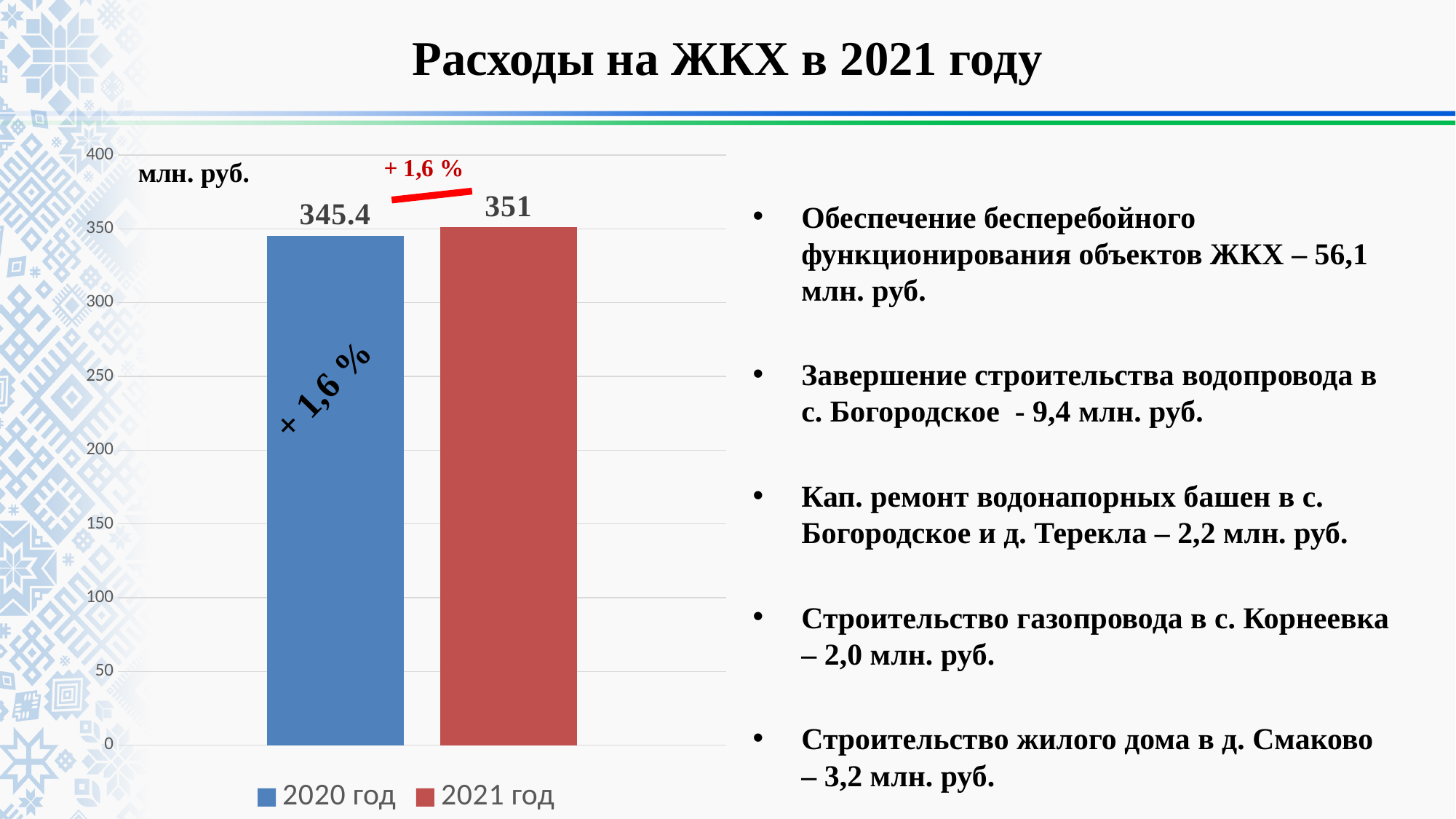
Is the value for 2021 год greater or less than 350? greater How many bars are plotted in the chart? 2 What kind of chart is shown on the slide? bar chart How many entries does the legend list? 2 Which year has the higher value, 2020 год or 2021 год? 2021 год Which bar is the lowest? 2020 год What is the difference between the values for 2021 год and 2020 год? 5.6 What is the value for 2021 год? 351 Do the values rise or fall from 2020 год to 2021 год? rise What percentage change is annotated between the two bars? + 1,6 % Is the value for 2020 год greater or less than 350? less What is the value for 2020 год? 345.4